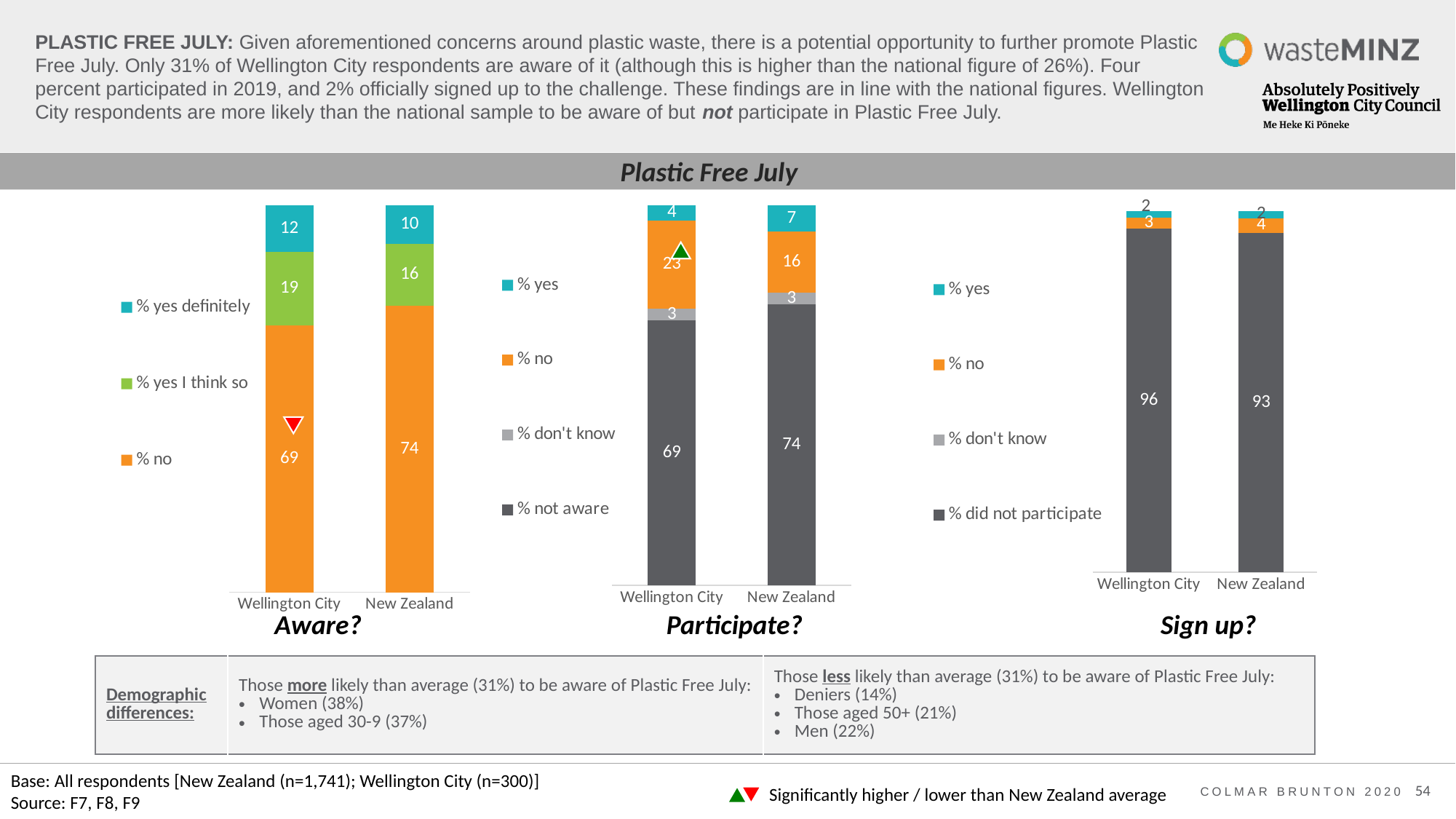
In the "Participate?" chart, how many series does the legend list? 4 In the "Sign up?" chart, what is the "% did not participate" value for Wellington City? 96 In the "Sign up?" chart, what is the "% no" value for New Zealand? 4 What type of chart is the "Sign up?" chart? Stacked bar chart In the "Participate?" chart, what is the "% no" value for Wellington City? 23 In the "Participate?" chart, what is the difference between the "% not aware" values for New Zealand and Wellington City? 5 How many categories are shown on the x axis of the "Aware?" chart? 2 In the "Aware?" chart, what is the "% no" value for Wellington City? 69 In the "Participate?" chart, which has the larger "% yes" value, Wellington City or New Zealand? New Zealand In the "Aware?" chart, how many series does the legend list? 3 In the "Aware?" chart, what is the "% yes I think so" value for New Zealand? 16 In the "Aware?" chart, what is the difference between the "% yes definitely" values for Wellington City and New Zealand? 2